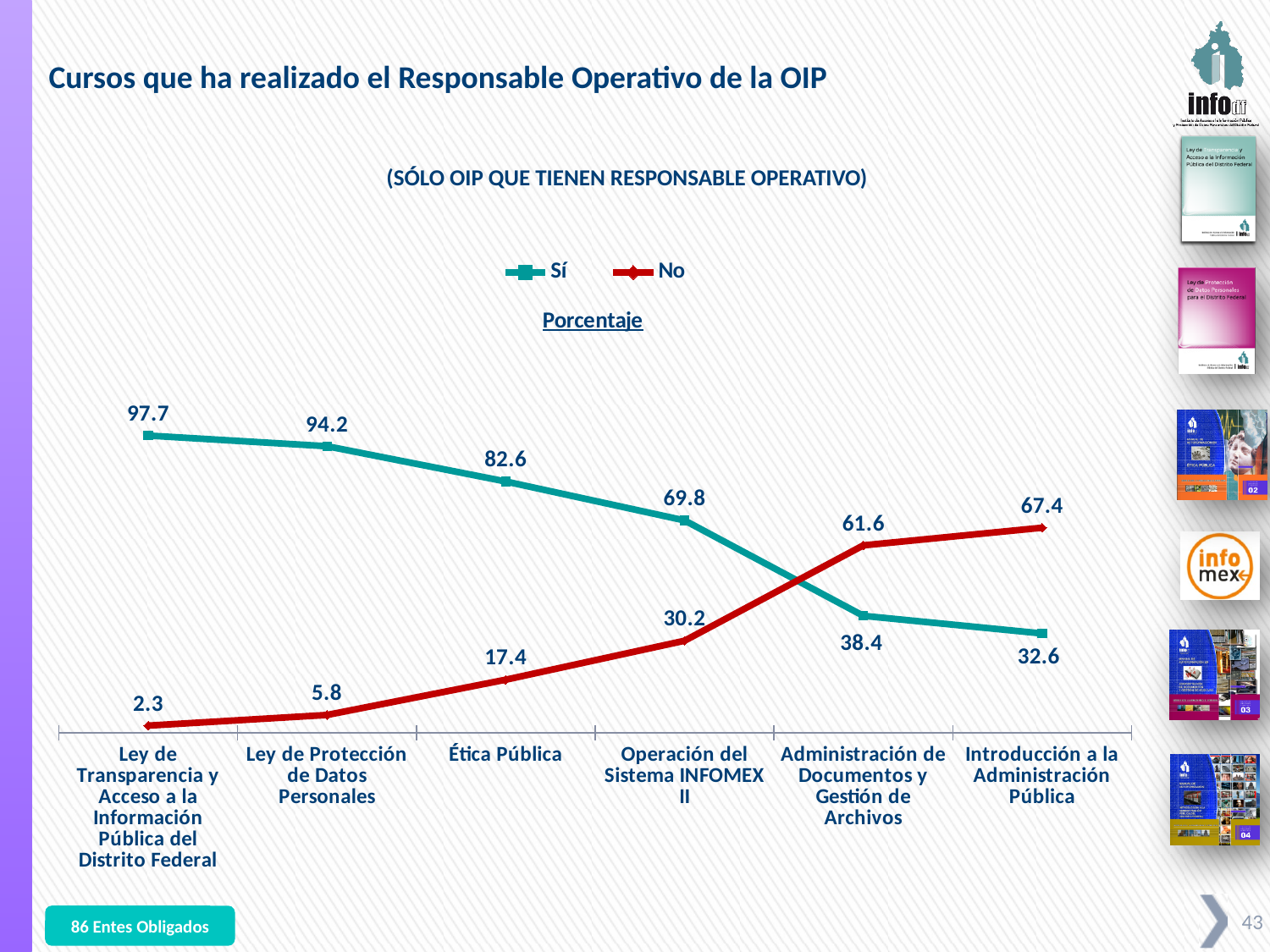
What colour is the 'Sí' line in the chart? Teal What is the difference between the 'Sí' and 'No' values for Administración de Documentos y Gestión de Archivos? 23.2 What is the 'Sí' value for Introducción a la Administración Pública? 32.6 What is the 'No' value for Operación del Sistema INFOMEX II? 30.2 What is the 'Sí' value for Ética Pública? 82.6 For Ley de Protección de Datos Personales, which is larger, the 'Sí' value or the 'No' value? Sí Which category has the lowest 'No' value? Ley de Transparencia y Acceso a la Información Pública del Distrito Federal What kind of chart is shown on the slide? Line chart How many series does the legend list? 2 Which category has the highest 'Sí' value? Ley de Transparencia y Acceso a la Información Pública del Distrito Federal Does the 'No' series rise or fall from left to right along the x axis? Rise How many categories are shown on the x axis? 6